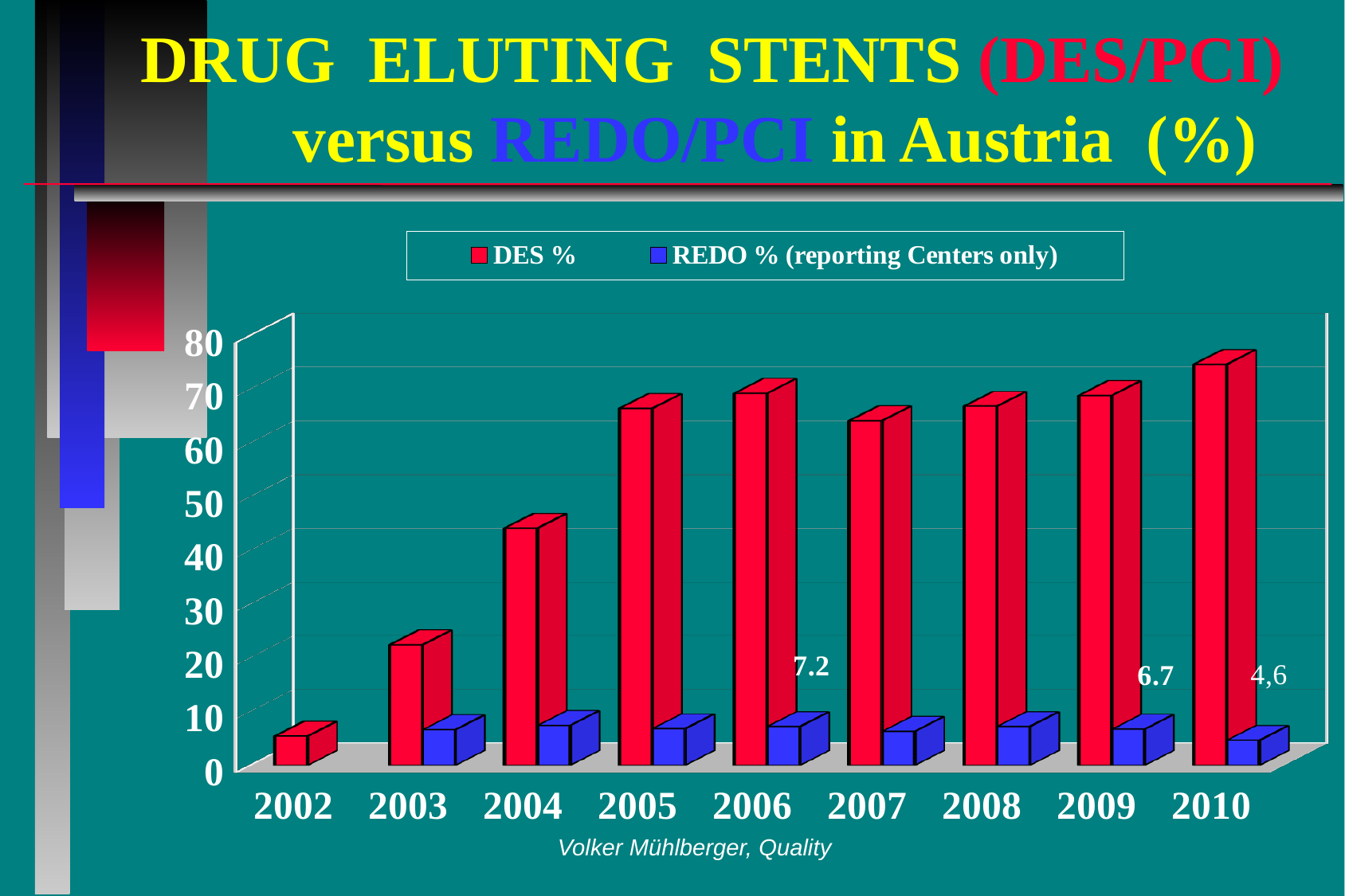
What is the REDO % value for 2006? 7.2 What kind of chart is shown on the slide? bar chart Is the DES % value for 2004 greater or less than 40? greater Is the DES % value for 2003 greater or less than 30? less Is the DES % value for 2002 greater or less than 10? less Which year has the lowest DES % value? 2002 Which is larger, the REDO % value for 2006 or for 2010? 2006 Which year has the highest DES % value? 2010 What is the REDO % value for 2010? 4,6 What is the REDO % value for 2009? 6.7 How many series does the legend list? 2 How many years are shown on the x axis? 9